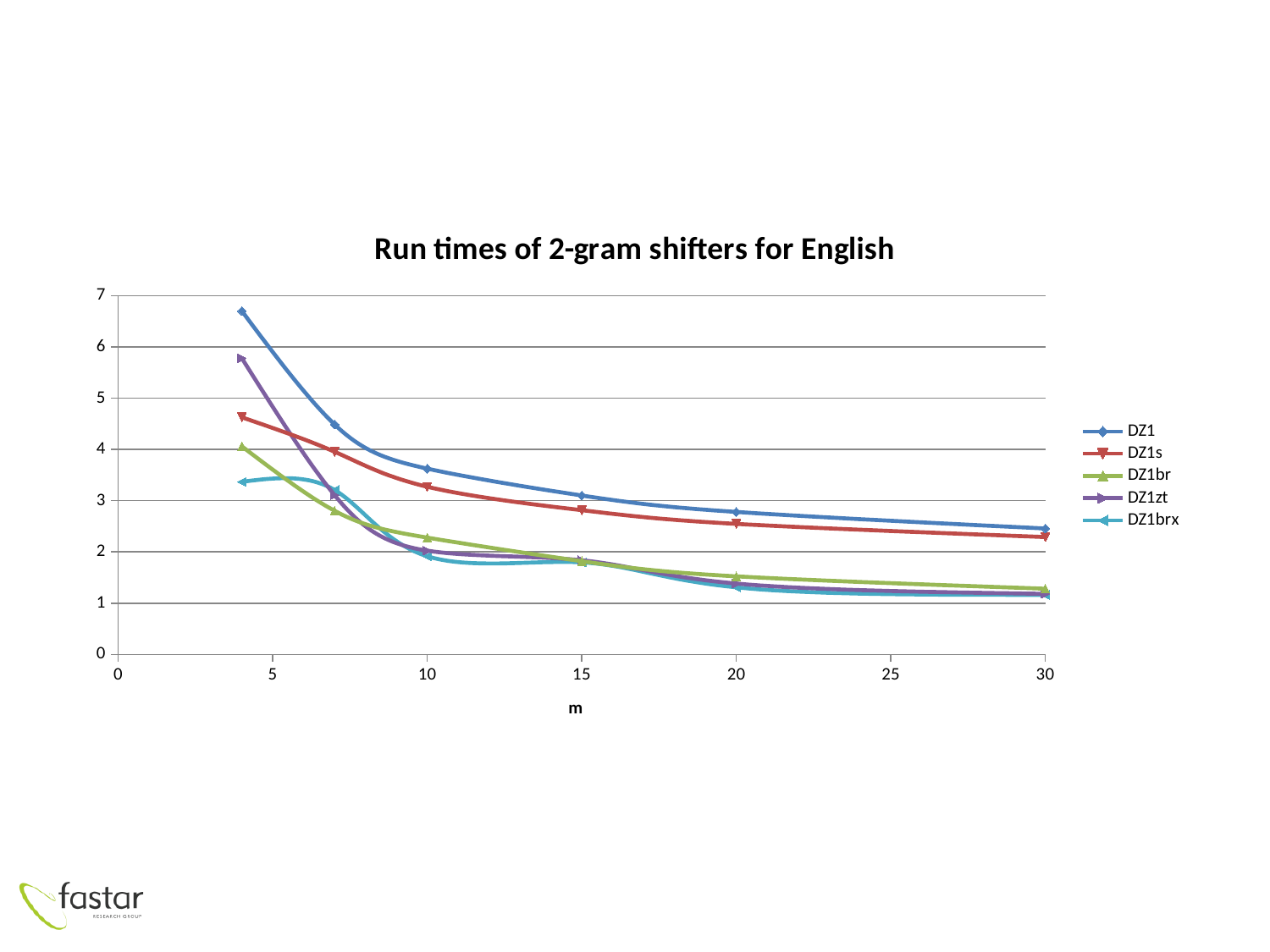
Which series has the highest value at m = 4? DZ1 How many series does the legend list? 5 What is the title of the chart? Run times of 2-gram shifters for English What kind of chart is shown on the slide? line chart Is the value for DZ1 at m = 30 greater or less than 3? less Is the value for DZ1 at m = 4 greater or less than 6? greater Which series has the highest value at m = 30? DZ1 At m = 10, which is larger, DZ1 or DZ1s? DZ1 Is the value for DZ1zt at m = 4 greater or less than 5? greater Which series has the lowest value at m = 4? DZ1brx Does the DZ1 series rise or fall as m increases? fall What is the label of the x axis? m